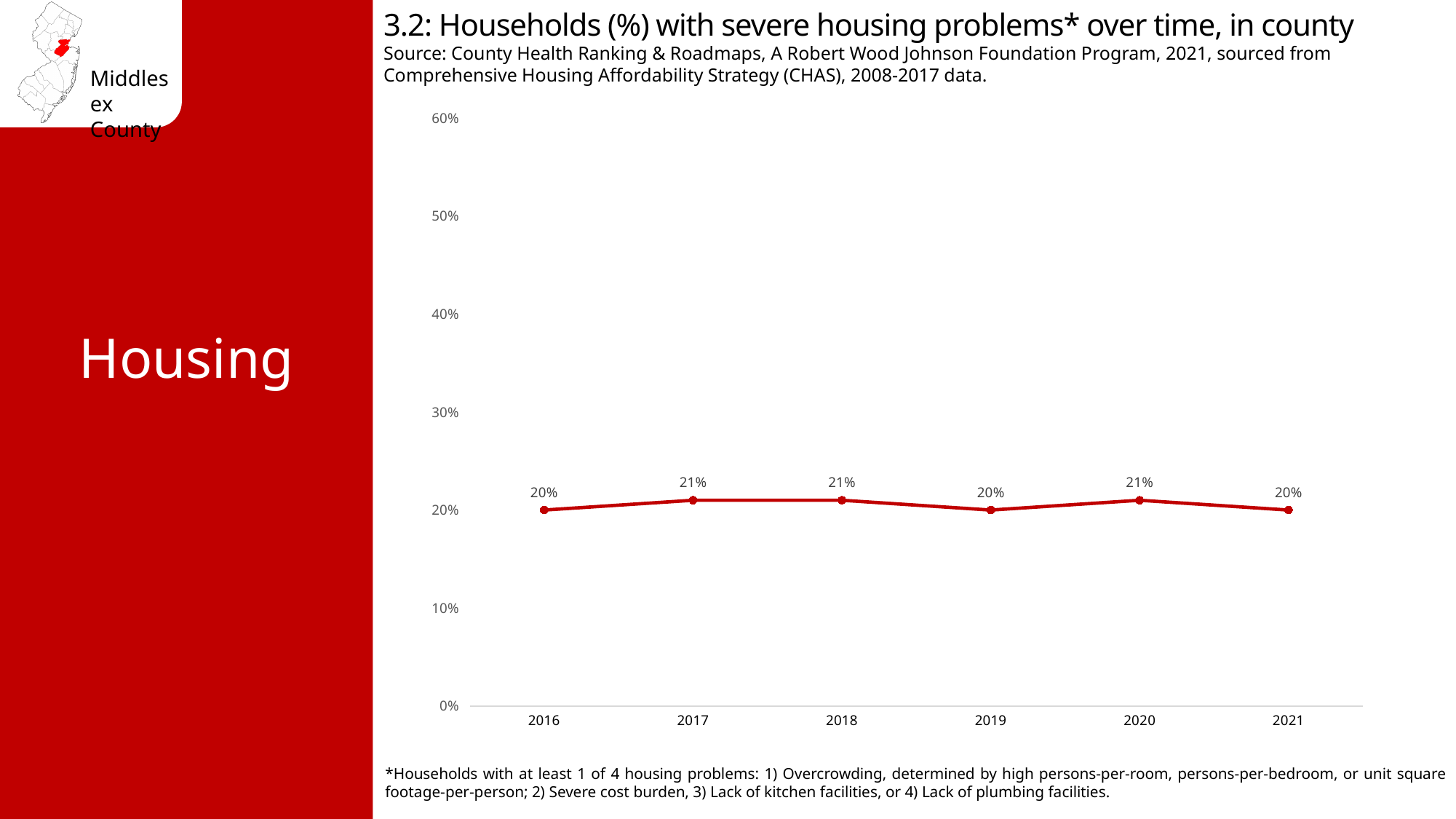
What is the highest value shown on the y axis? 60% What percentage of households had severe housing problems in 2019? 20% What percentage of households had severe housing problems in 2016? 20% Which is larger, the value for 2017 or the value for 2019? 2017 Is the value for 2020 greater or less than 10%? greater How many years are plotted on the chart? 6 What is the first year shown on the x axis? 2016 What percentage of households had severe housing problems in 2021? 20% What is the difference between the 2020 value and the 2021 value? 1% Is the value for 2018 greater or less than 30%? less What kind of chart is shown on the slide? line chart What percentage of households had severe housing problems in 2017? 21%